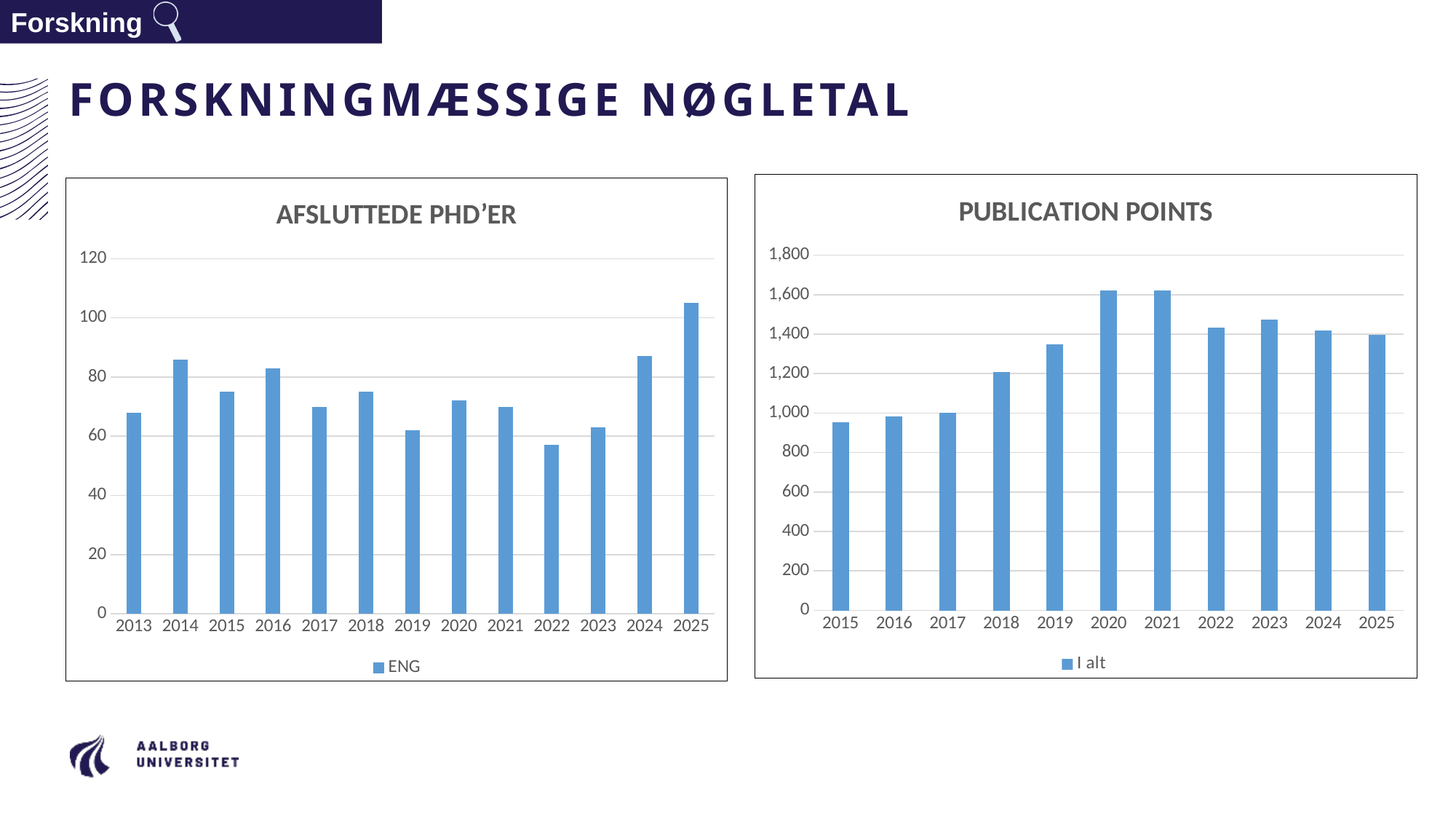
In the PUBLICATION POINTS chart, which year has the lowest value? 2015 In the AFSLUTTEDE PHD'ER chart, which is larger, the value for 2013 or the value for 2014? 2014 What type of chart is the PUBLICATION POINTS chart? bar chart In the AFSLUTTEDE PHD'ER chart, is the value for 2025 greater or less than 100? greater In the PUBLICATION POINTS chart, is the value for 2015 greater or less than 1,000? less In the AFSLUTTEDE PHD'ER chart, which year has the highest value? 2025 In the PUBLICATION POINTS chart, which is larger, the value for 2018 or the value for 2019? 2019 In the AFSLUTTEDE PHD'ER chart, is the value for 2022 greater or less than 60? less In the AFSLUTTEDE PHD'ER chart, which year has the lowest value? 2022 What series name does the legend of the AFSLUTTEDE PHD'ER chart show? ENG How many years are shown on the x axis of the AFSLUTTEDE PHD'ER chart? 13